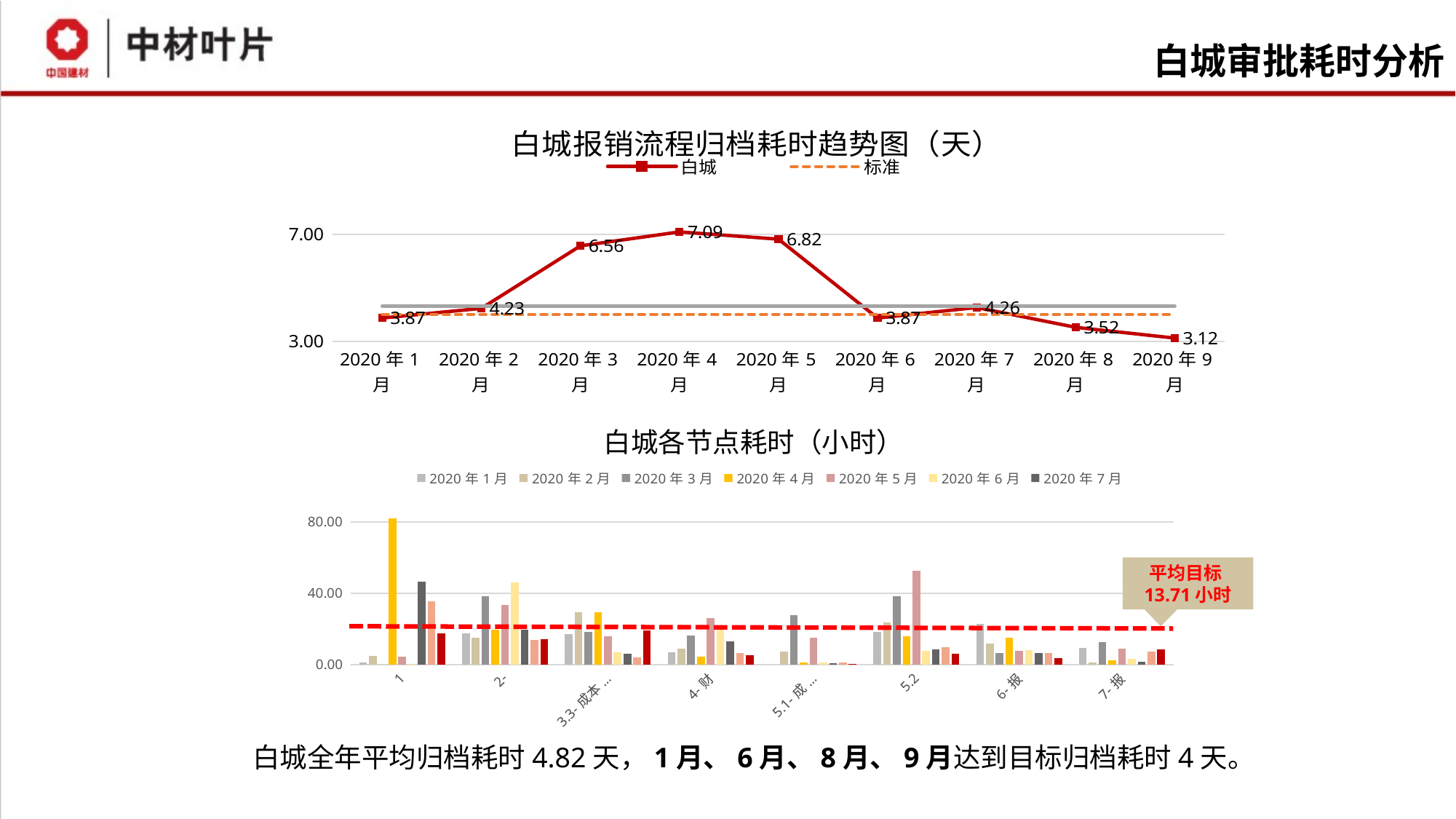
In the bottom chart 白城各节点耗时（小时）, how many series does the legend list? 7 In the top chart 白城报销流程归档耗时趋势图（天）, how many months are plotted on the x axis? 9 In the top chart 白城报销流程归档耗时趋势图（天）, what is the difference between the values for 2020年4月 and 2020年9月? 3.97 In the top chart 白城报销流程归档耗时趋势图（天）, what is the value for 2020年4月? 7.09 What kind of chart is the bottom chart 白城各节点耗时（小时）? Bar chart In the top chart 白城报销流程归档耗时趋势图（天）, which month has the highest value? 2020年4月 In the top chart 白城报销流程归档耗时趋势图（天）, what is the value for 2020年9月? 3.12 What kind of chart is the top chart 白城报销流程归档耗时趋势图（天）? Line chart In the bottom chart 白城各节点耗时（小时）, is the value for 2020年4月 at category 1 greater or less than 40.00? greater In the top chart 白城报销流程归档耗时趋势图（天）, which month has the lowest value? 2020年9月 In the top chart 白城报销流程归档耗时趋势图（天）, which is larger, the value for 2020年3月 or 2020年5月? 2020年5月